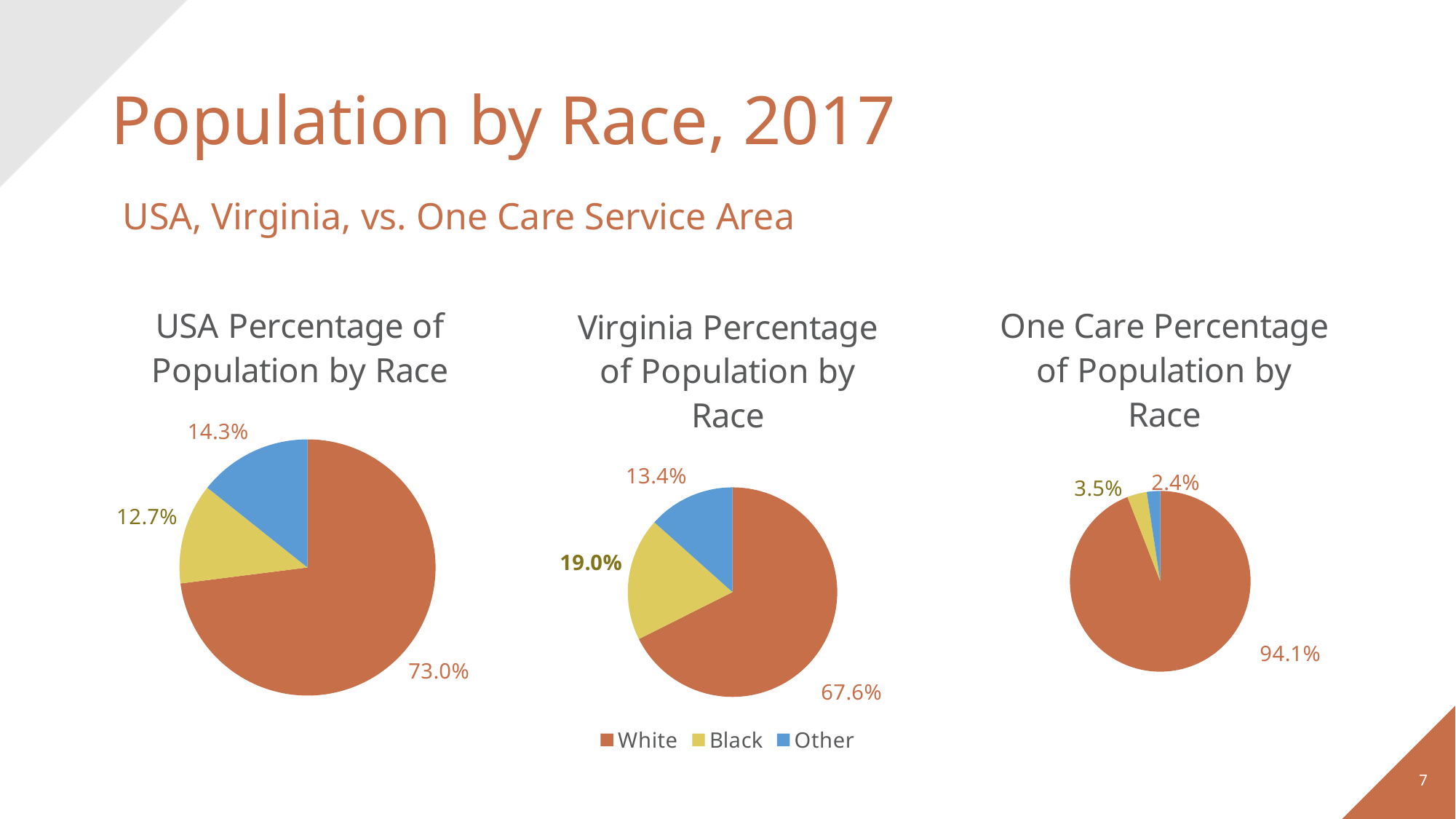
In the 'USA Percentage of Population by Race' chart, what percentage is shown for Black? 12.7% Which is larger: the Black percentage in the 'Virginia Percentage of Population by Race' chart or the Black percentage in the 'USA Percentage of Population by Race' chart? Virginia What is the difference between the White percentage in the 'One Care Percentage of Population by Race' chart and the White percentage in the 'USA Percentage of Population by Race' chart? 21.1% In the 'Virginia Percentage of Population by Race' chart, what percentage is shown for Black? 19.0% In the 'One Care Percentage of Population by Race' chart, what percentage is shown for White? 94.1% In the 'USA Percentage of Population by Race' chart, what percentage is shown for White? 73.0% In the 'USA Percentage of Population by Race' chart, which category has the largest slice? White What type of chart is the 'Virginia Percentage of Population by Race' chart? Pie chart How many categories does the legend list for the 'Virginia Percentage of Population by Race' chart? 3 In the 'Virginia Percentage of Population by Race' chart, what percentage is shown for Other? 13.4% In the 'One Care Percentage of Population by Race' chart, what percentage is shown for Other? 2.4% In the 'One Care Percentage of Population by Race' chart, which category has the smallest slice? Other